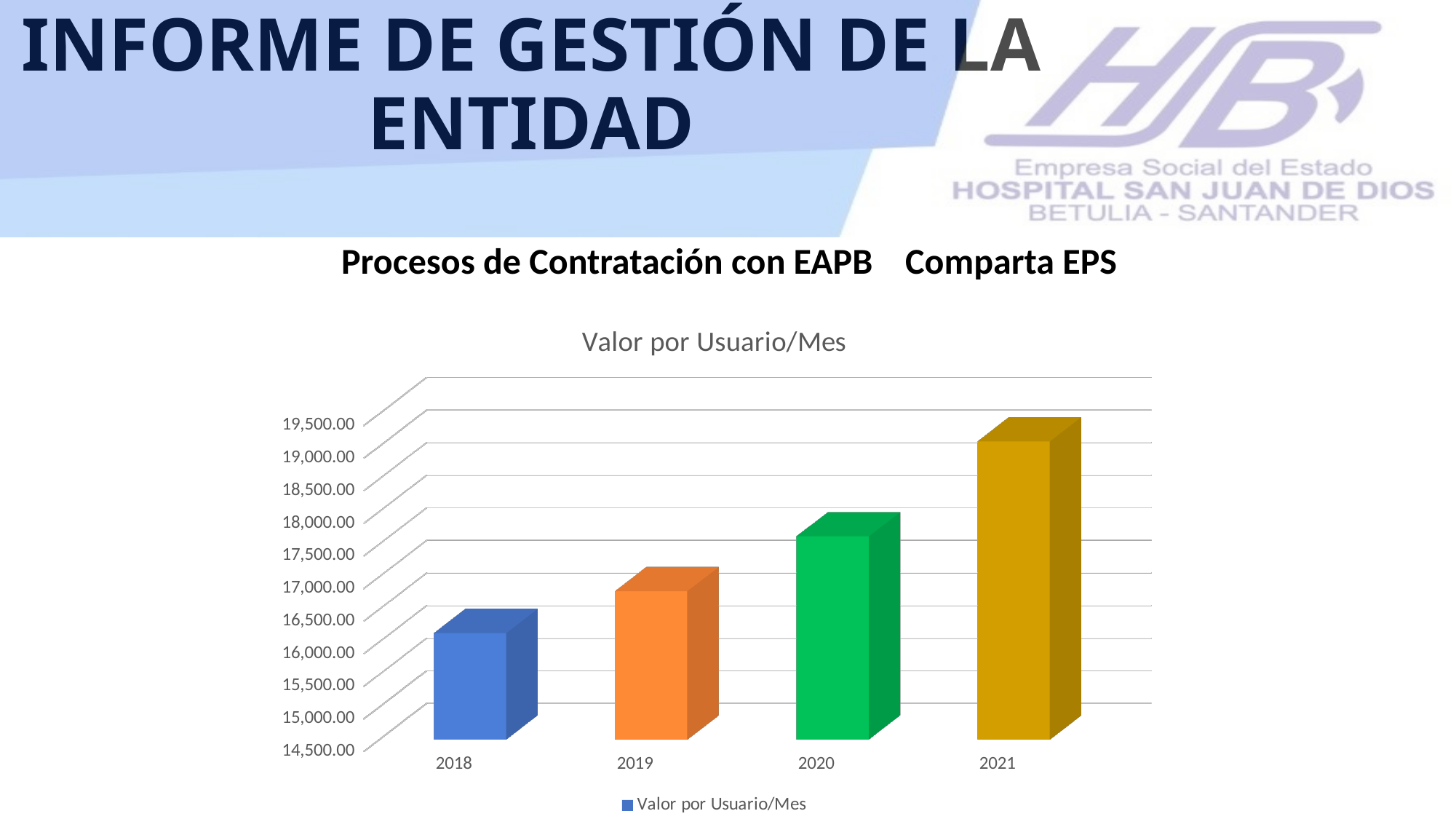
Is the value for 2019 greater or less than 16,500.00? greater Is the value for 2021 greater or less than 18,500.00? greater How many series does the chart legend list? 1 What is the title of the chart? Valor por Usuario/Mes Is the value for 2020 greater or less than 18,000.00? less Do the values rise or fall from 2018 to 2021? Rise How many years are shown on the x axis of the chart? 4 Which year has the highest Valor por Usuario/Mes? 2021 Which year has the lowest Valor por Usuario/Mes? 2018 Which is larger, the value for 2020 or the value for 2019? 2020 What kind of chart is shown on the slide? Bar chart